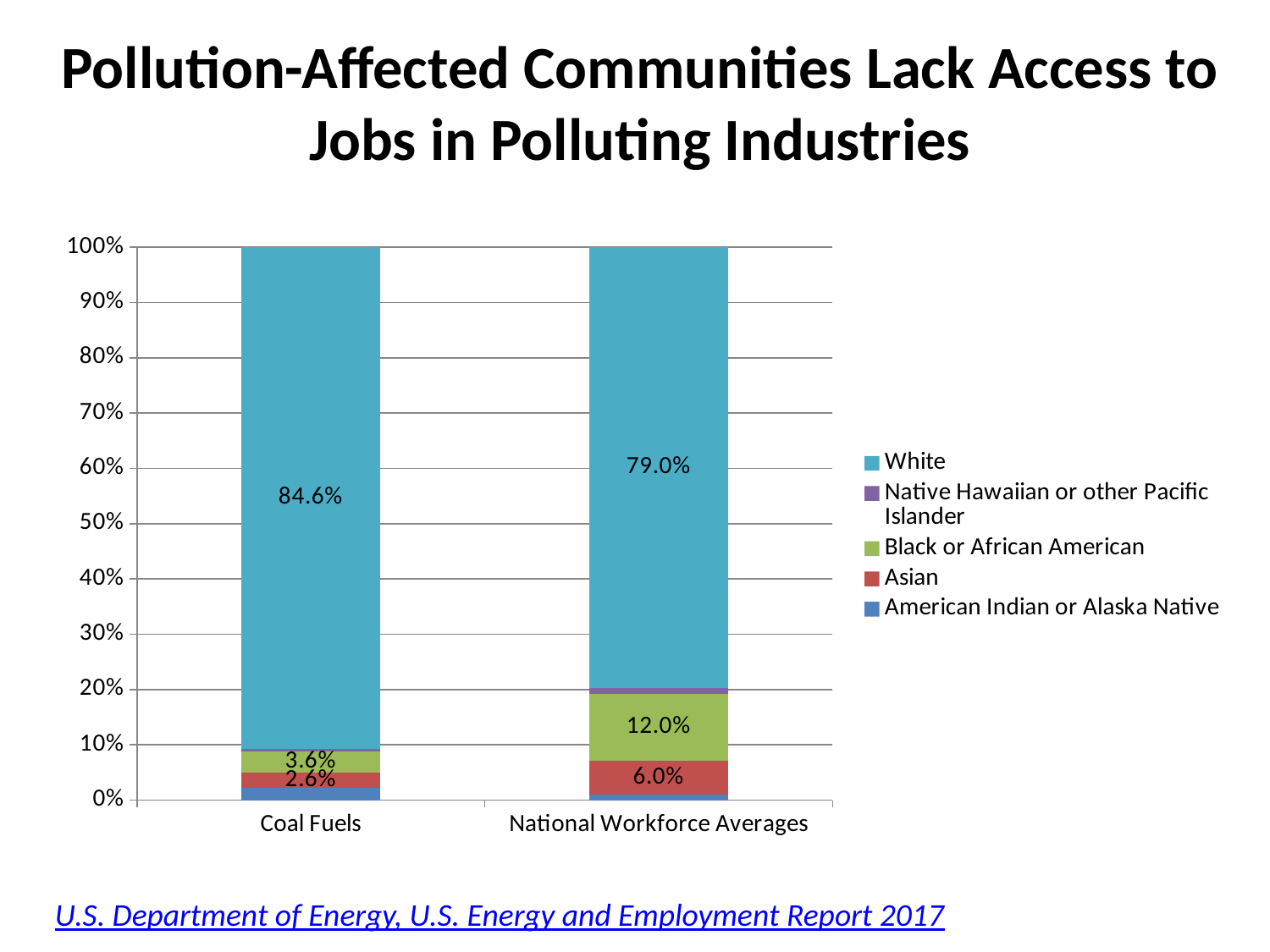
What kind of chart is shown on the slide? Stacked bar chart What is the value for Black or African American in the Coal Fuels bar? 3.6% What is the value for White in the National Workforce Averages bar? 79.0% What is the difference between the White share for Coal Fuels and for National Workforce Averages? 5.6% What is the value for Asian in the National Workforce Averages bar? 6.0% What is the value for Asian in the Coal Fuels bar? 2.6% What is the value for Black or African American in the National Workforce Averages bar? 12.0% How many series does the legend list? 5 What is the value for White in the Coal Fuels bar? 84.6% Which category has the larger White share, Coal Fuels or National Workforce Averages? Coal Fuels How many categories are shown on the x axis? 2 What is the difference between the Black or African American share for National Workforce Averages and for Coal Fuels? 8.4%